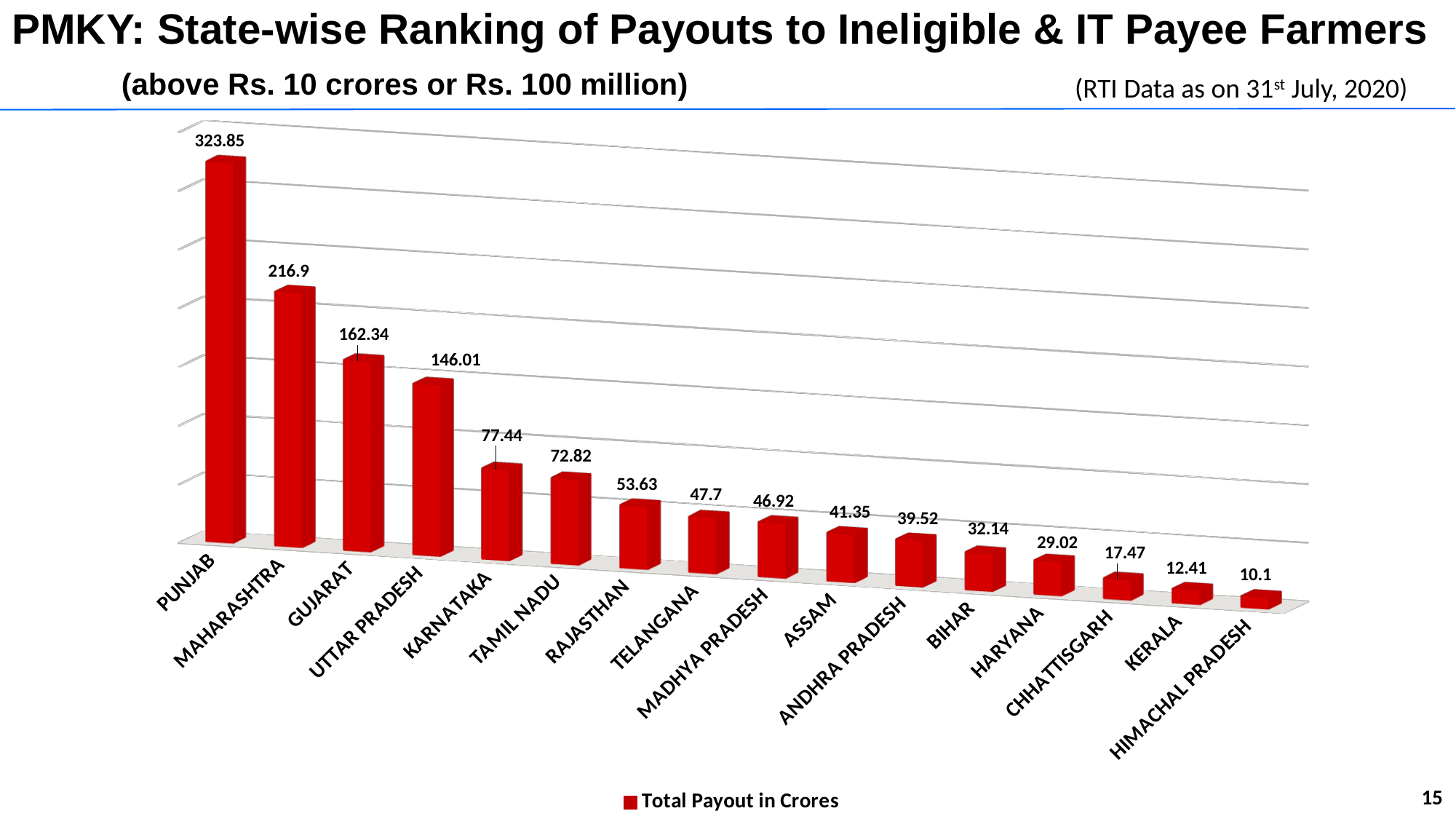
What is the total payout in crores for Punjab? 323.85 How many states are shown in the chart? 16 Which state has the highest total payout? Punjab What is the total payout in crores for Chhattisgarh? 17.47 What is the difference between the payouts for Gujarat and Uttar Pradesh? 16.33 What is the difference between the payouts for Punjab and Maharashtra? 106.95 Which state has the lowest total payout? Himachal Pradesh Which has a larger payout, Rajasthan or Assam? Rajasthan What is the total payout in crores for Uttar Pradesh? 146.01 How many series does the legend list? 1 What is the total payout in crores for Telangana? 47.7 What kind of chart is shown on the slide? Bar chart